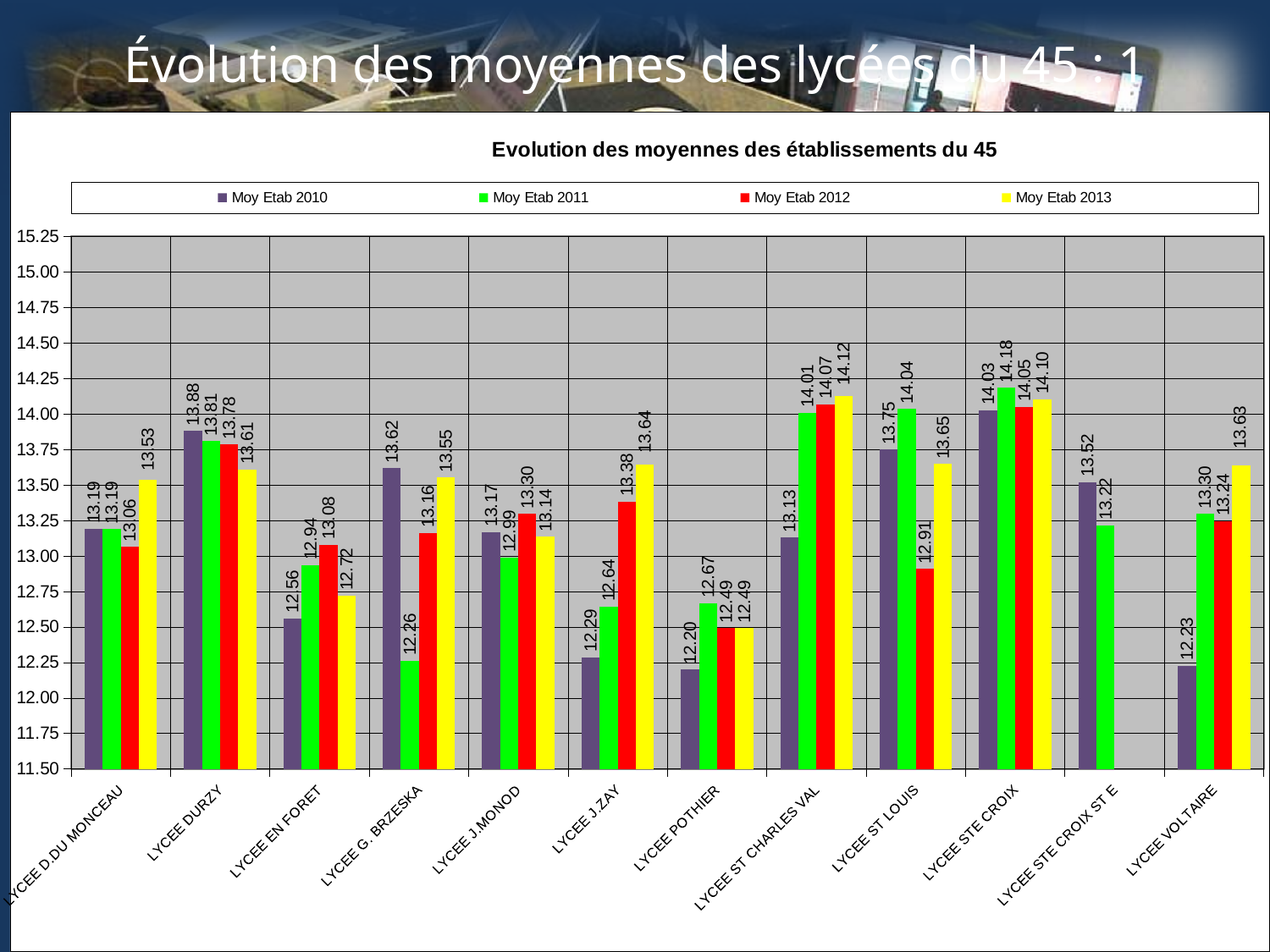
Which lycée has the highest Moy Etab 2011 value? LYCEE STE CROIX Do the values for LYCEE J.ZAY rise or fall from Moy Etab 2010 to Moy Etab 2013? rise What is the difference between the Moy Etab 2010 and Moy Etab 2013 values for LYCEE DURZY? 0.27 What kind of chart is shown on the slide? bar chart How many series does the legend list? 4 What is the Moy Etab 2013 value for LYCEE J.ZAY? 13.64 What is the Moy Etab 2012 value for LYCEE ST LOUIS? 12.91 Is the Moy Etab 2011 value for LYCEE G. BRZESKA greater or less than 12.50? less Which is larger: the Moy Etab 2012 value for LYCEE EN FORET or for LYCEE J.MONOD? LYCEE J.MONOD Which lycée has the lowest Moy Etab 2010 value? LYCEE POTHIER How many lycées are shown on the x axis? 12 What is the Moy Etab 2010 value for LYCEE DURZY? 13.88